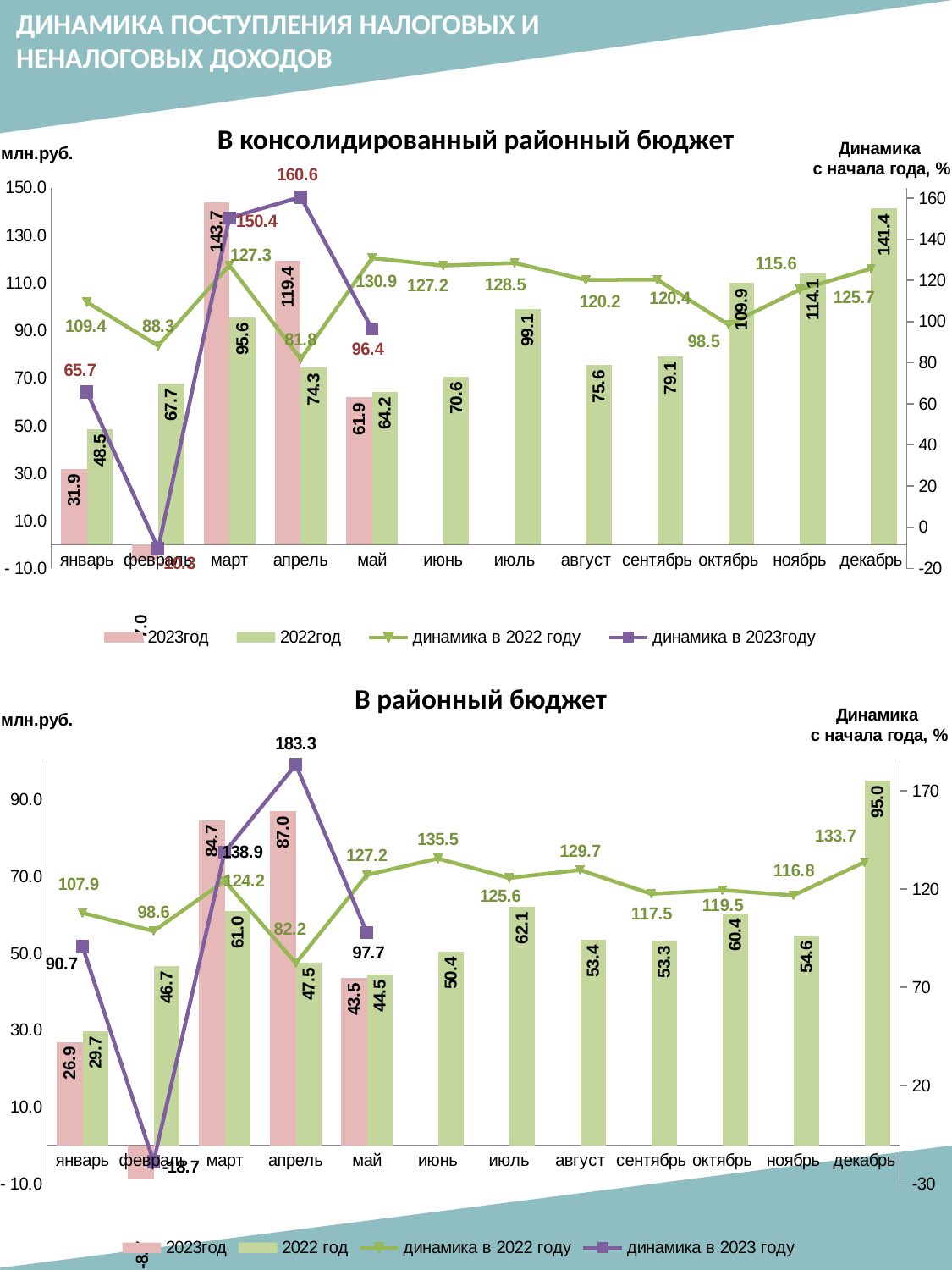
In the chart 'В консолидированный районный бюджет', what is the 2023год value for март? 143.7 In the chart 'В районный бюджет', what is the value of the 'динамика в 2023 году' line for апрель? 183.3 In the chart 'В районный бюджет', which month has the highest 2022 год value? декабрь In the chart 'В консолидированный районный бюджет', which month has the highest value for the 'динамика в 2023году' line? апрель In the chart 'В районный бюджет', what is the 2023год value for апрель? 87.0 In the chart 'В районный бюджет', which is larger for май: the 2023год value or the 2022 год value? 2022 год In the chart 'В районный бюджет', how many months are shown on the x axis? 12 In the chart 'В консолидированный районный бюджет', which month has the lowest value on the 'динамика в 2022 году' line? апрель In the chart 'В консолидированный районный бюджет', what is the 2022год value for декабрь? 141.4 What type of chart is 'В районный бюджет'? Combined bar and line chart In the chart 'В консолидированный районный бюджет', how many series does the legend list? 4 In the chart 'В консолидированный районный бюджет', what is the difference between the 2023год and 2022год values for апрель? 45.1